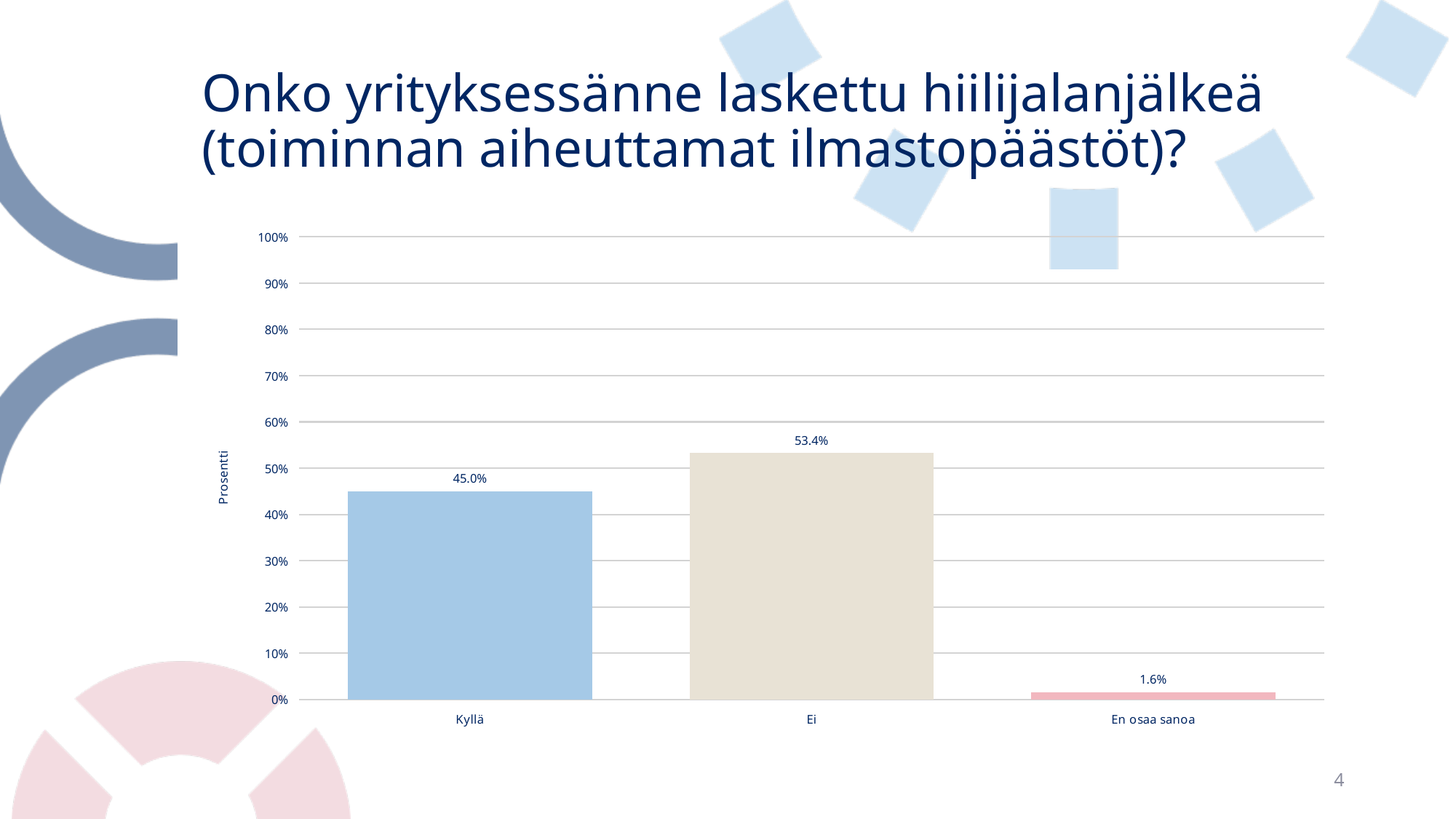
What is the value for En osaa sanoa? 1.6% Which category has the lowest value? En osaa sanoa Which category has the highest value? Ei What kind of chart is shown on the slide? bar chart What colour is the bar for En osaa sanoa? pink How many categories are shown on the x axis? 3 What is the label of the y axis? Prosentti What is the value for Ei? 53.4% Which is larger, the value for Kyllä or the value for Ei? Ei Is the value for Kyllä greater or less than 50%? less What is the difference between the values for Ei and Kyllä? 8.4% What is the value for Kyllä? 45.0%